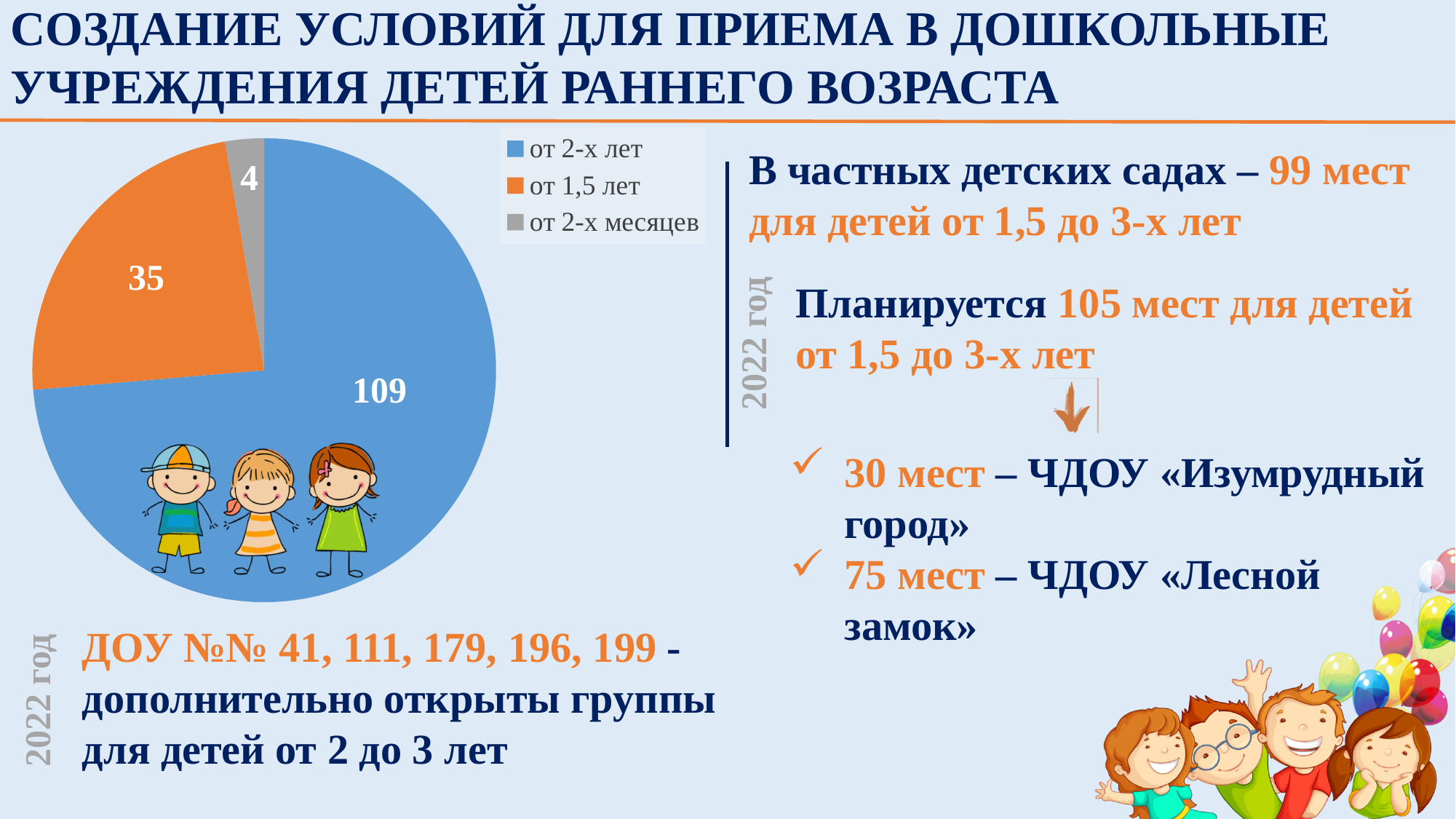
What is the value for "от 2-х месяцев" in the pie chart? 4 How many slices does the pie chart have? 3 Which category has the smallest slice in the pie chart? от 2-х месяцев How many entries does the legend of the pie chart list? 3 Which is larger in the pie chart: "от 1,5 лет" or "от 2-х месяцев"? от 1,5 лет What is the difference between the values for "от 2-х лет" and "от 1,5 лет"? 74 Which category has the largest slice in the pie chart? от 2-х лет What is the value for "от 2-х лет" in the pie chart? 109 What type of chart is shown on the slide? pie chart Which colour represents "от 1,5 лет" in the pie chart? orange What is the total of all slices in the pie chart? 148 What is the value for "от 1,5 лет" in the pie chart? 35